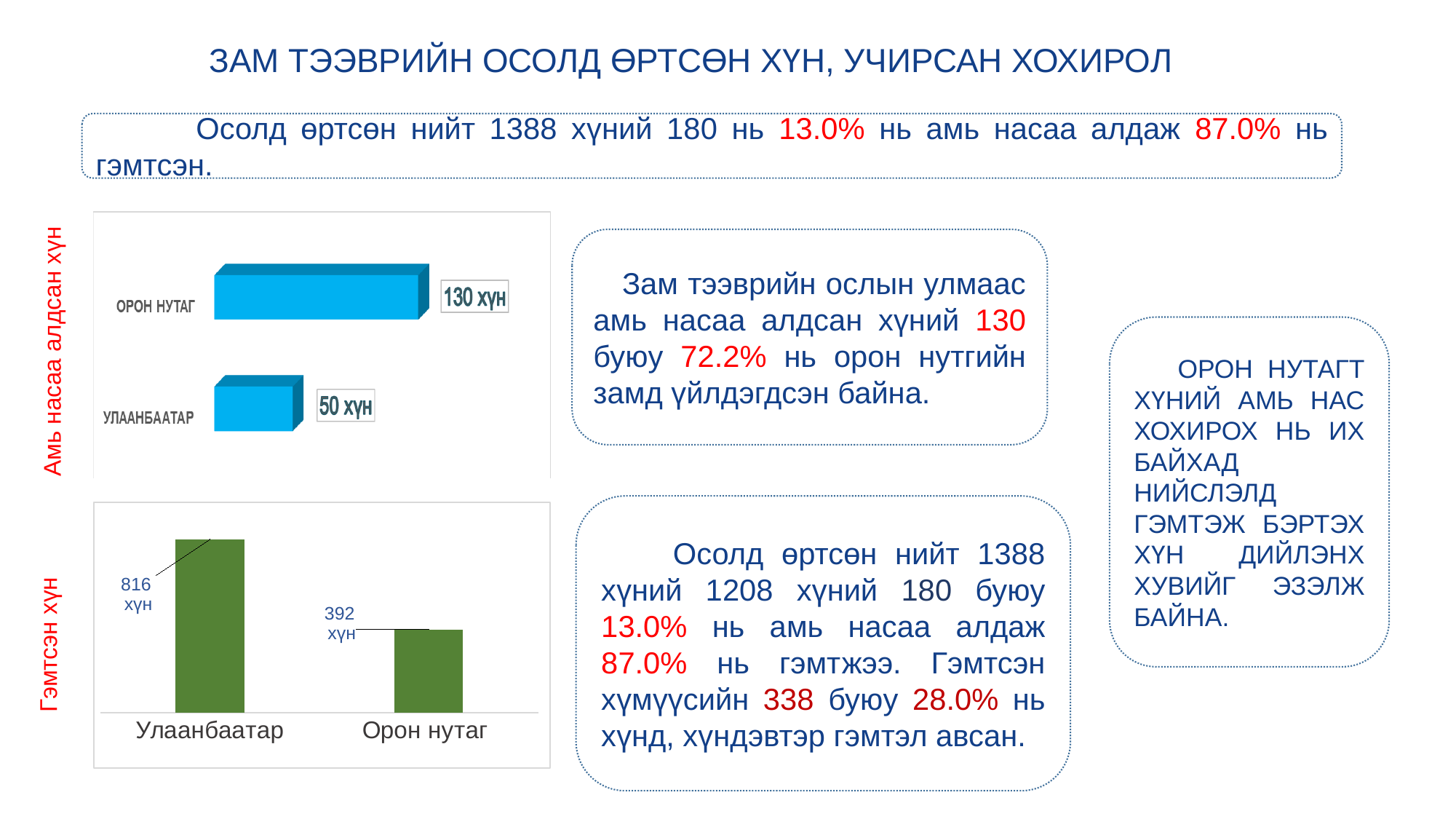
In the bottom chart (Гэмтсэн хүн), which is larger, Улаанбаатар or Орон нутаг? Улаанбаатар In the bottom chart (Гэмтсэн хүн), what is the value for Орон нутаг? 392 хүн In the bottom chart (Гэмтсэн хүн), what is the difference between Улаанбаатар and Орон нутаг? 424 хүн In the top chart (Амь насаа алдсан хүн), what is the value for УЛААНБААТАР? 50 хүн In the top chart (Амь насаа алдсан хүн), what is the value for ОРОН НУТАГ? 130 хүн In the top chart (Амь насаа алдсан хүн), how many categories are shown? 2 What colour are the bars in the bottom chart (Гэмтсэн хүн)? Green In the bottom chart (Гэмтсэн хүн), what is the value for Улаанбаатар? 816 хүн What kind of chart is the top chart (Амь насаа алдсан хүн)? Bar chart In the top chart (Амь насаа алдсан хүн), what is the difference between ОРОН НУТАГ and УЛААНБААТАР? 80 хүн In the bottom chart (Гэмтсэн хүн), which category has the lowest value? Орон нутаг In the top chart (Амь насаа алдсан хүн), which category has the highest value? ОРОН НУТАГ